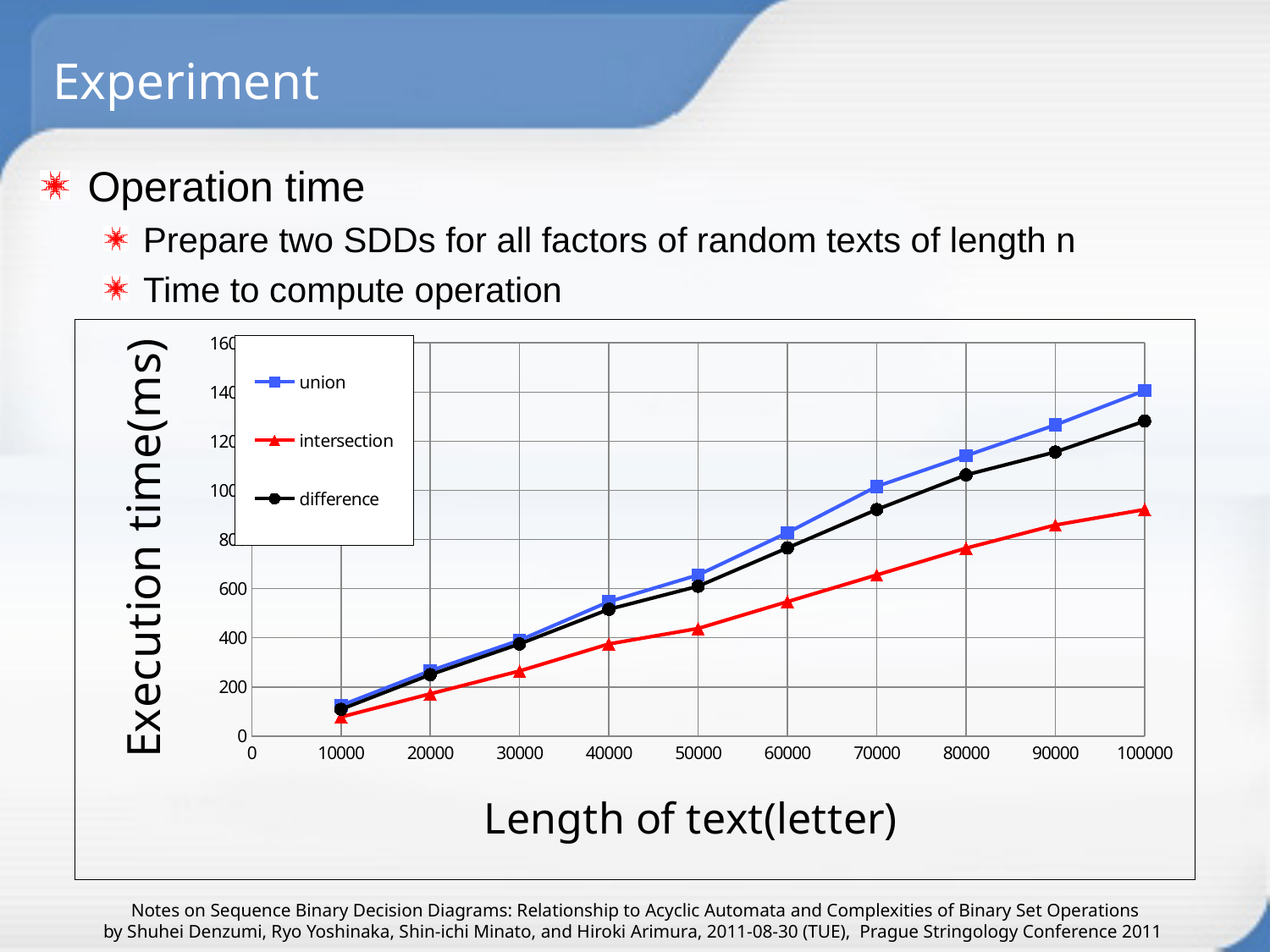
At a text length of 100000, which has the larger execution time, union or difference? union Which series has the lowest execution time at a text length of 100000? intersection Is the execution time for intersection at a text length of 70000 greater or less than 800? less How many series does the legend list? 3 Does the execution time for intersection rise or fall as the length of text increases? rise What kind of chart is shown on the slide? line chart Which series has the highest execution time at a text length of 100000? union Is the execution time for intersection at a text length of 100000 greater or less than 1000? less Is the execution time for union at a text length of 100000 greater or less than 1200? greater What is the label of the y axis? Execution time(ms) How many data points are plotted for the union series? 10